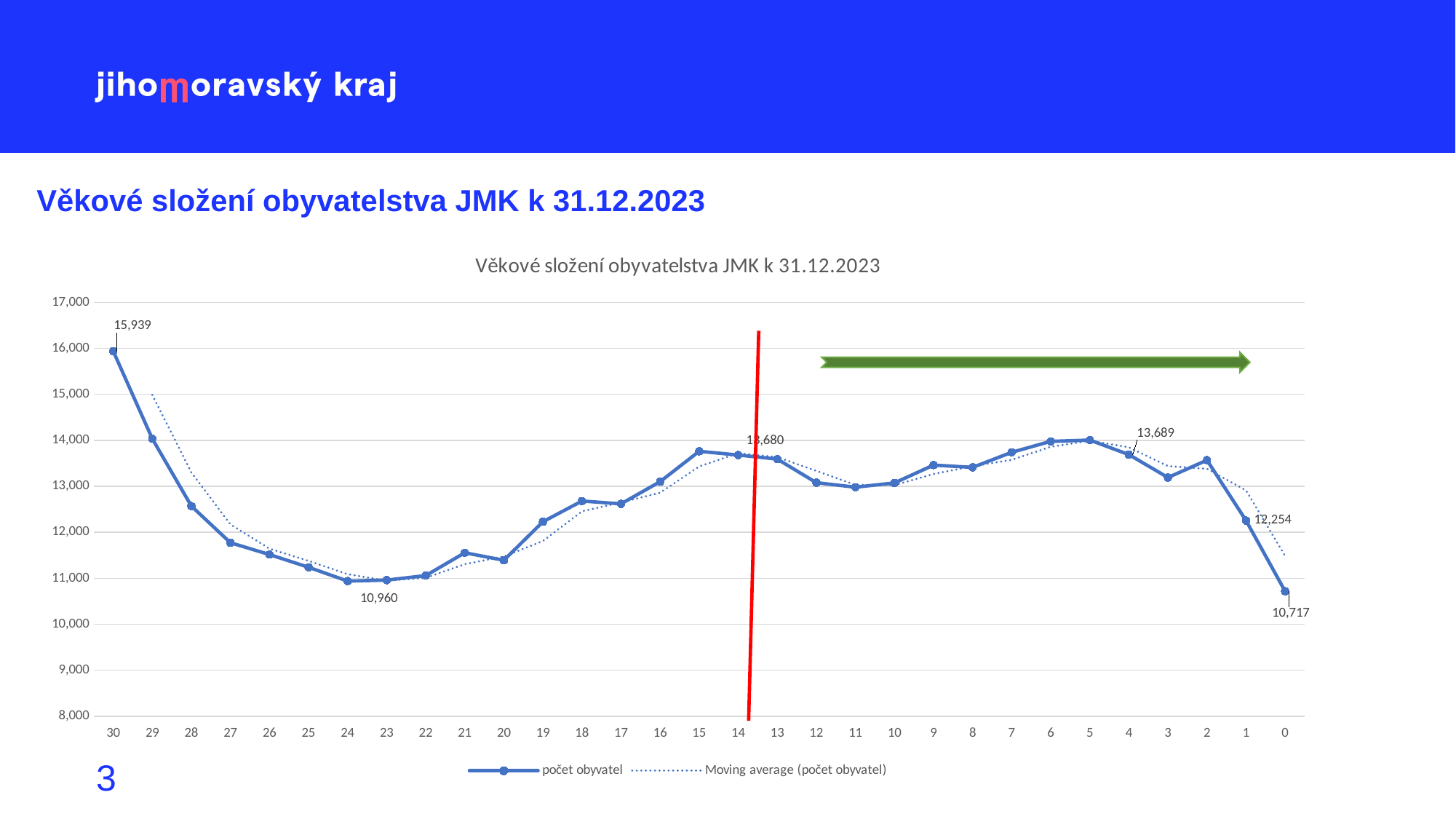
What is the value for age 1 in the chart? 12,254 Which age has the lowest value in the chart? 0 Is the value for age 15 greater or less than 13,000? greater What kind of chart is shown on the slide? line chart What is the value for age 30 in the chart? 15,939 What is the difference between the values for age 30 and age 0? 5,222 Which age has the highest value in the chart? 30 How many series does the legend list? 2 What is the difference between the values for age 1 and age 0? 1,537 What is the value for age 0 in the chart? 10,717 Is the value for age 27 greater or less than 12,000? less